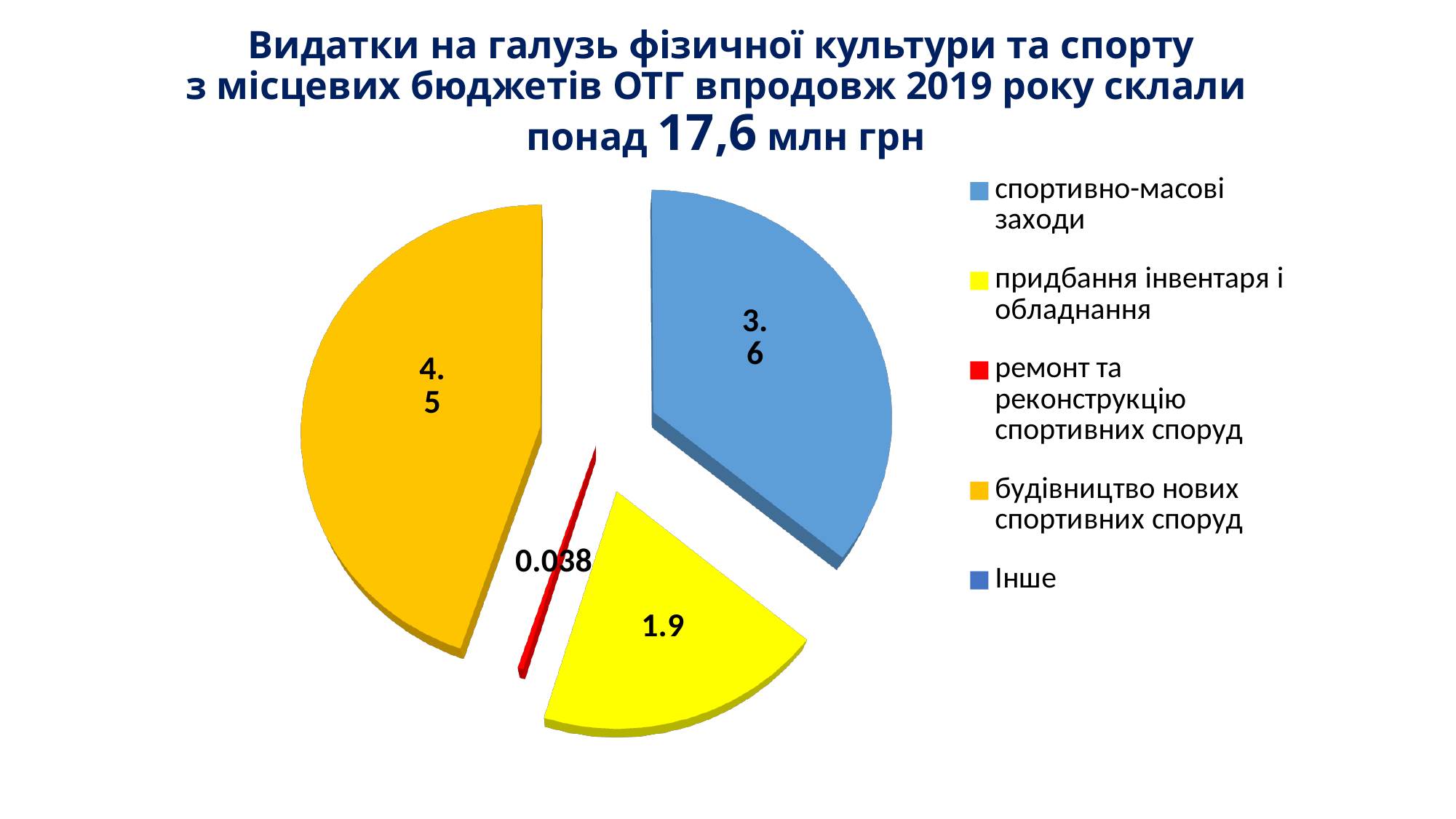
What is the value shown for будівництво нових спортивних споруд? 4.5 Which category has the largest slice of the pie? будівництво нових спортивних споруд What is the difference between the values for спортивно-масові заходи and придбання інвентаря і обладнання? 1.7 What kind of chart is shown on the slide? pie chart What is the value shown for придбання інвентаря і обладнання? 1.9 What is the value shown for спортивно-масові заходи? 3.6 Which category has the smallest slice of the pie? ремонт та реконструкцію спортивних споруд What is the difference between the values for будівництво нових спортивних споруд and спортивно-масові заходи? 0.9 How many entries does the legend list? 5 Which is larger: спортивно-масові заходи or придбання інвентаря і обладнання? спортивно-масові заходи What colour is the slice for будівництво нових спортивних споруд? orange What is the value shown for ремонт та реконструкцію спортивних споруд? 0.038